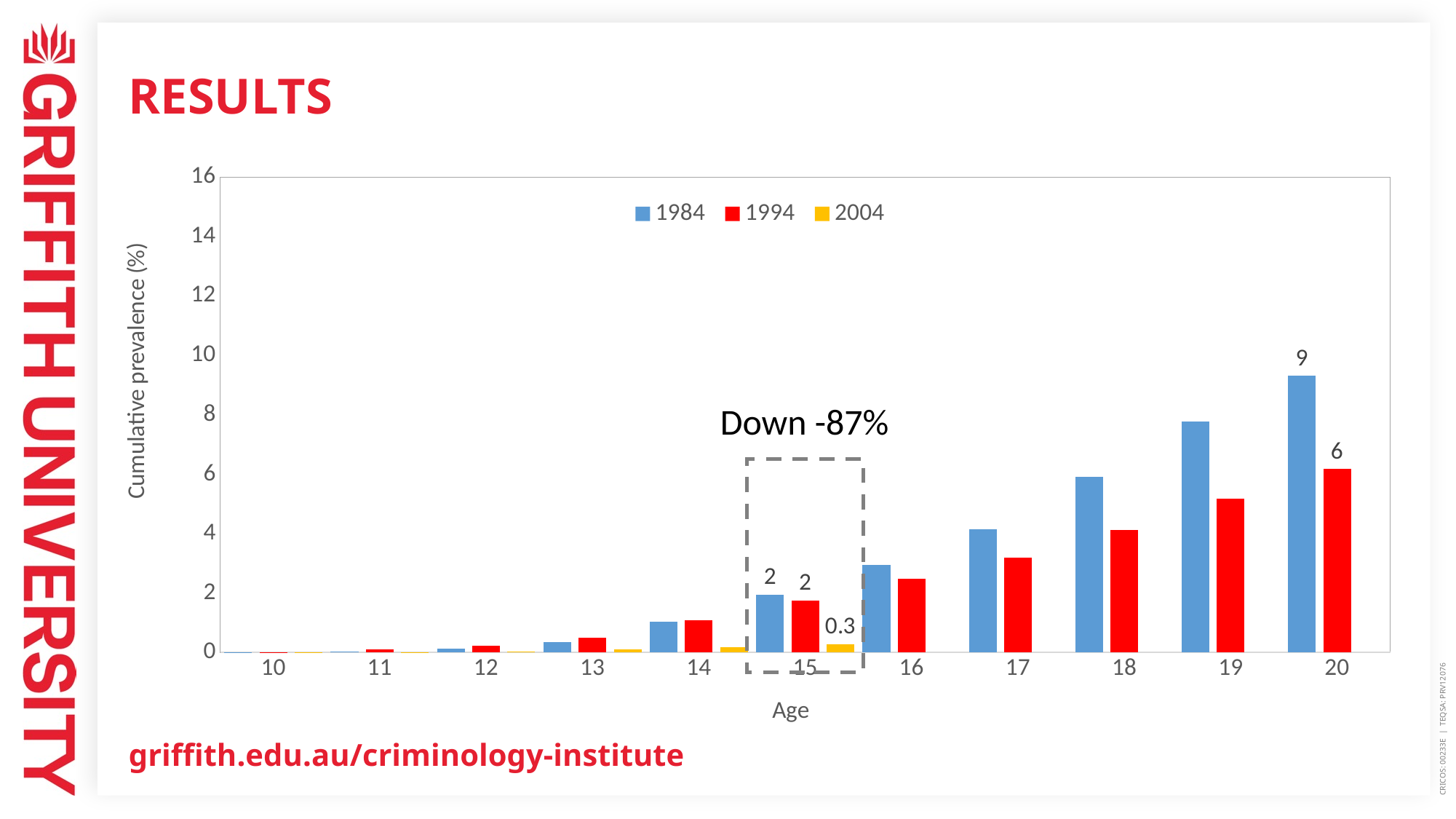
Is the value for the 1994 series at age 18 greater or less than 6? less What is the labelled value for the 1994 series at age 20? 6 What is the label on the y axis? Cumulative prevalence (%) What type of chart is shown on the slide? Bar chart What is the difference between the 1984 and 1994 values at age 20? 3 What is the labelled value for the 2004 series at age 15? 0.3 How many age categories are shown on the x axis? 11 Is the value for the 1984 series at age 19 greater or less than 6? greater What is the labelled value for the 1984 series at age 20? 9 How many series does the legend list? 3 Do the values for the 1984 series rise or fall as age increases? Rise At age 20, which series has the larger value, 1984 or 1994? 1984